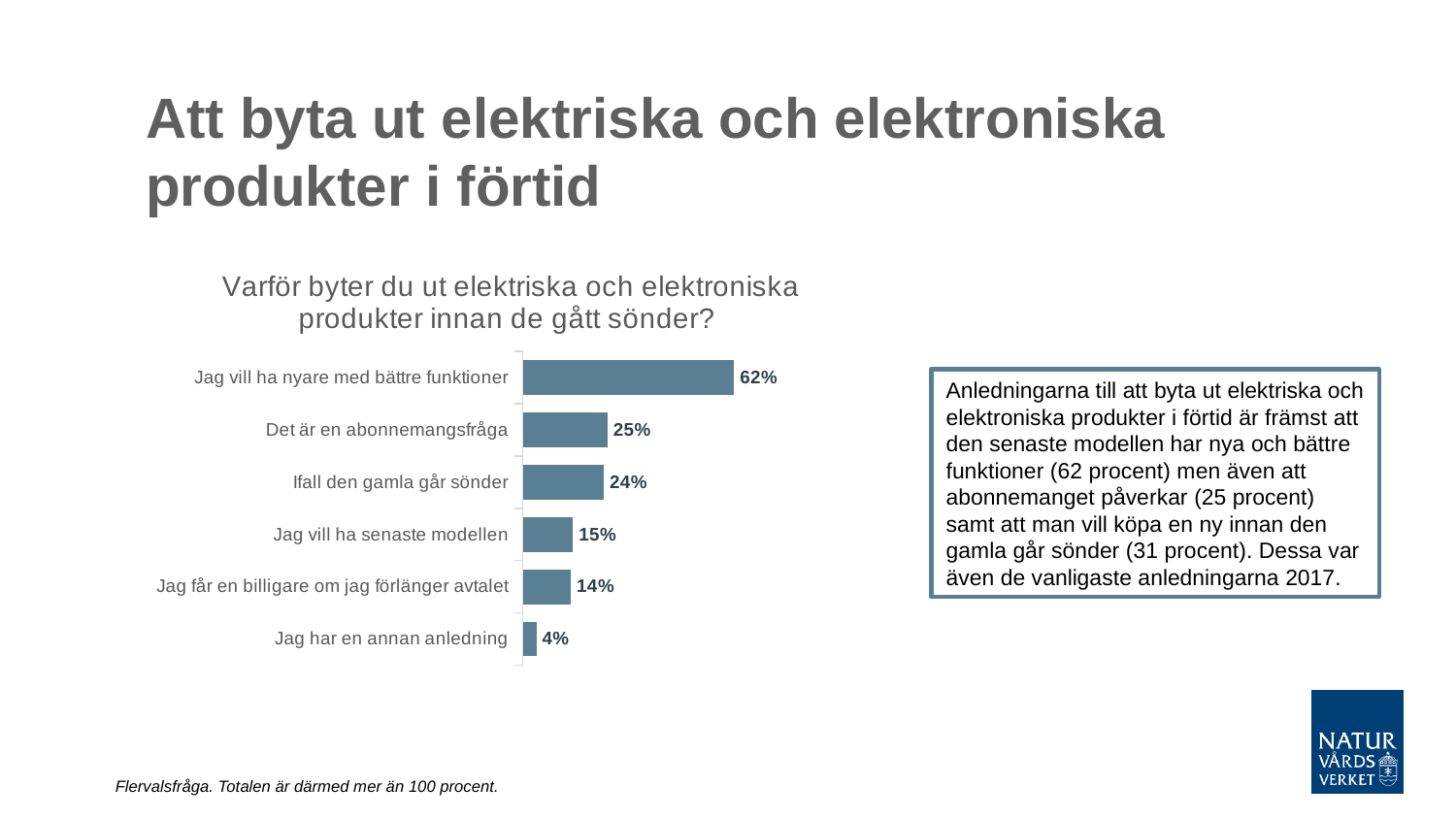
What is the value for "Ifall den gamla går sönder"? 24% What is the difference between "Jag vill ha nyare med bättre funktioner" and "Det är en abonnemangsfråga"? 37 percentage points Which category has the highest value? Jag vill ha nyare med bättre funktioner Which category has the lowest value? Jag har en annan anledning What is the value for "Jag vill ha nyare med bättre funktioner"? 62% What is the value for "Det är en abonnemangsfråga"? 25% What is the value for "Jag får en billigare om jag förlänger avtalet"? 14% Which is larger: "Jag vill ha senaste modellen" or "Jag har en annan anledning"? Jag vill ha senaste modellen What kind of chart is shown on the slide? Bar chart What is the title of the chart? Varför byter du ut elektriska och elektroniska produkter innan de gått sönder? What is the difference between "Ifall den gamla går sönder" and "Jag vill ha senaste modellen"? 9 percentage points How many categories are shown in the chart? 6